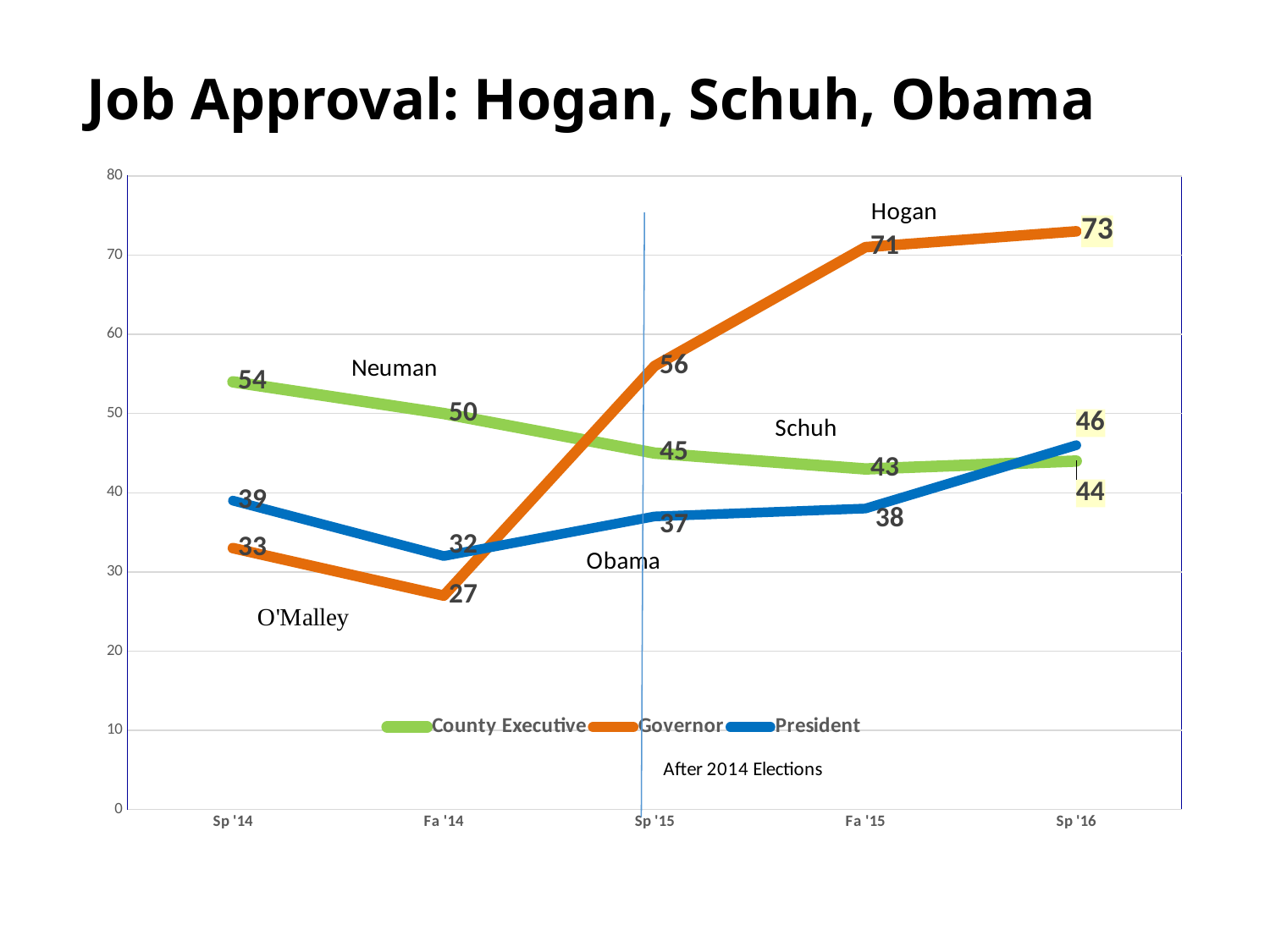
What is the County Executive job approval value at Sp '14? 54 Does the County Executive series rise or fall from Sp '14 to Fa '15? fall At which time point is the President series highest? Sp '16 Is the Governor value at Fa '15 greater or less than 60? greater What is the Governor job approval value at Sp '16? 73 What is the President job approval value at Fa '14? 32 How many time points are shown on the x axis? 5 Which series has the larger value at Sp '15, Governor or County Executive? Governor What is the difference between the Governor value at Sp '16 and the Governor value at Sp '14? 40 How many series does the legend list? 3 At which time point is the Governor series lowest? Fa '14 What kind of chart is shown on the slide? line chart